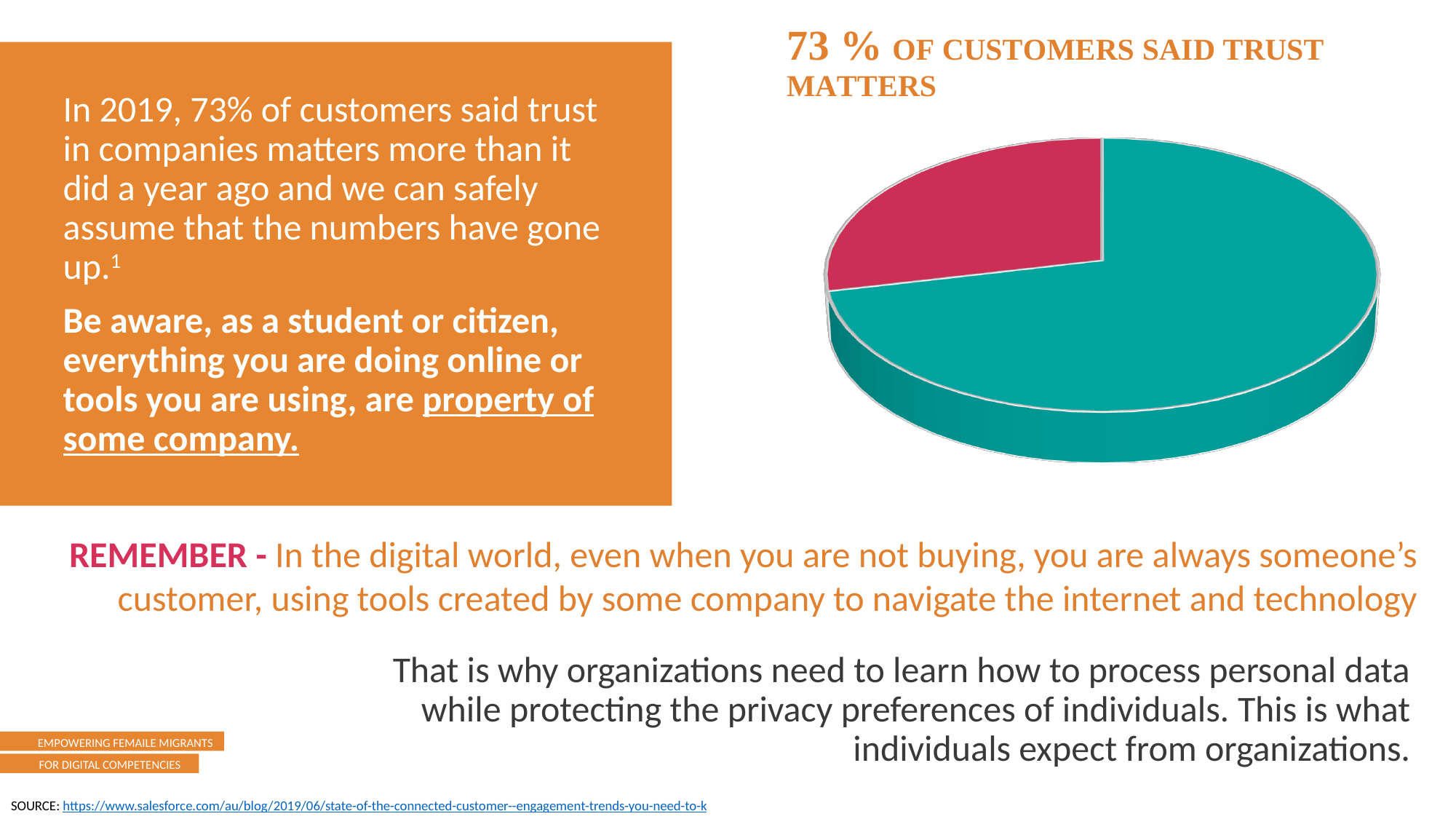
Which slice of the pie chart is larger, the teal one or the red one? the teal one How many slices does the pie chart have? 2 Is the teal slice of the pie chart greater or less than 50% of the pie? greater What is the title of the pie chart? 73 % OF CUSTOMERS SAID TRUST MATTERS What kind of chart is shown on the slide? pie chart Is the red slice of the pie chart greater or less than 50% of the pie? less Does the pie chart include a legend? No According to the chart title, what percentage of customers said trust matters? 73 % What colour is the largest slice of the pie chart? teal